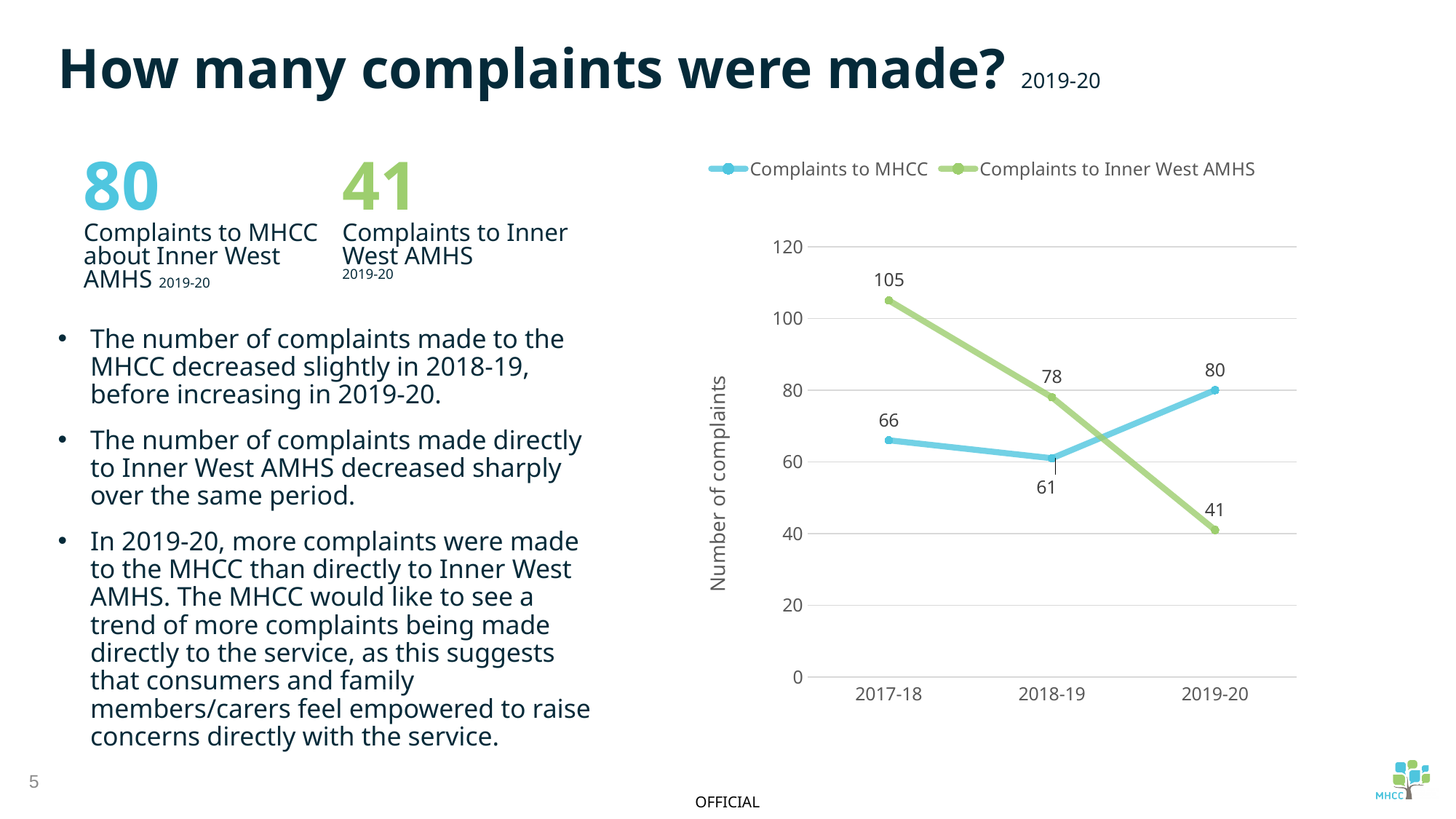
In which year were complaints to Inner West AMHS highest? 2017-18 How many complaints were made to Inner West AMHS in 2018-19? 78 Do complaints to Inner West AMHS rise or fall from 2017-18 to 2019-20? Fall What type of chart is shown on the slide? Line chart In 2019-20, which series had more complaints: Complaints to MHCC or Complaints to Inner West AMHS? Complaints to MHCC How many series does the chart legend list? 2 What is the difference between complaints to Inner West AMHS and complaints to MHCC in 2017-18? 39 What is the value for Complaints to Inner West AMHS in 2019-20? 41 In which year were complaints to MHCC lowest? 2018-19 What is the label of the chart's vertical axis? Number of complaints How many years are shown on the x axis of the chart? 3 How many complaints were made to MHCC in 2017-18? 66